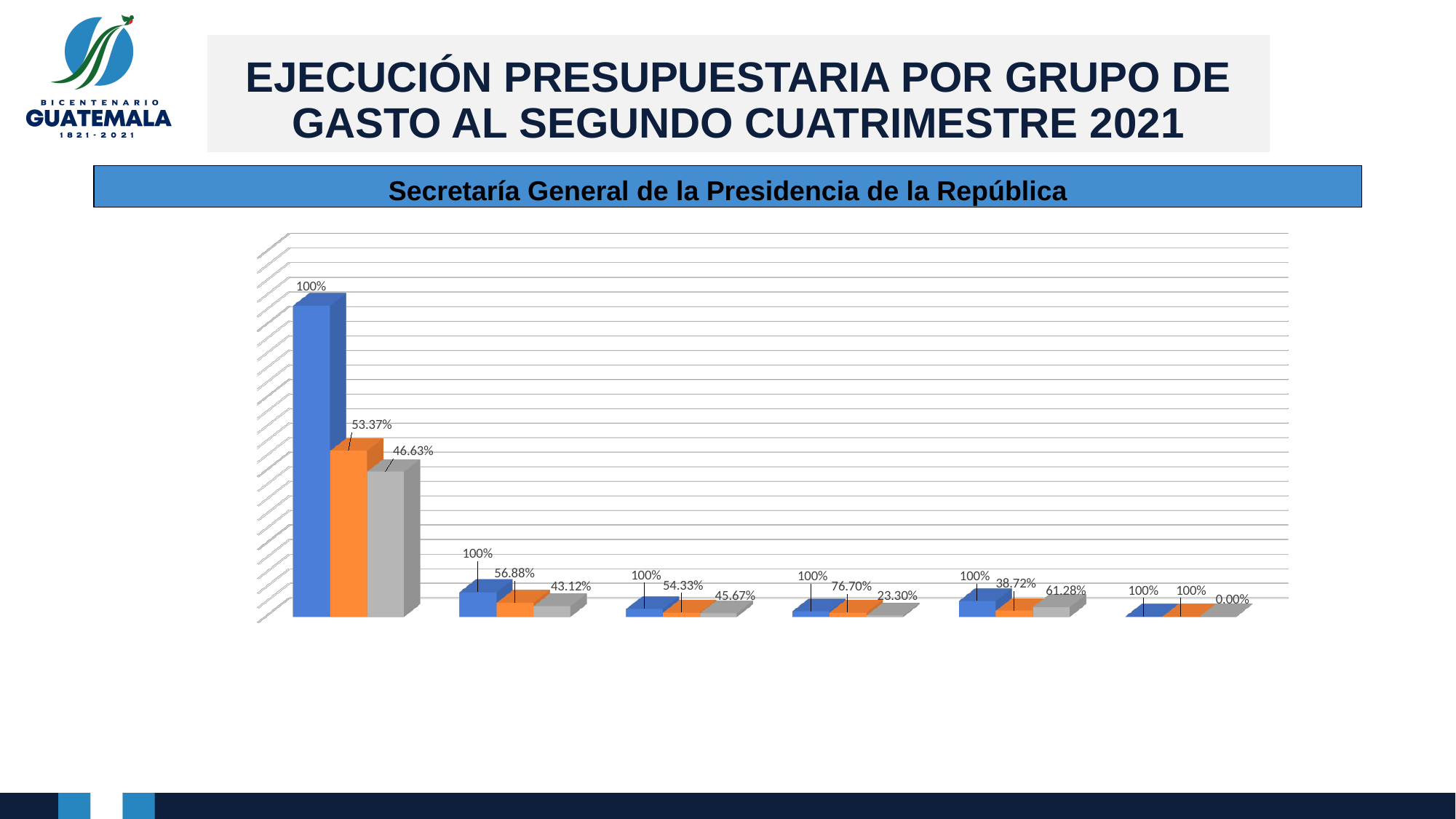
How many groups of bars are plotted in the chart? 6 What is the value of the orange bar in the fourth group of bars? 76.70% What is the value of the gray bar in the sixth (rightmost) group of bars? 0.00% What is the value of the gray bar in the first (leftmost) group of bars? 46.63% In which group of bars is the orange bar the highest? the first (leftmost) group What kind of chart is shown on the slide? bar chart In the first (leftmost) group of bars, what is the difference between the orange bar and the gray bar? 6.74 percentage points What is the value of the gray bar in the fifth group of bars? 61.28% In the fourth group of bars, which is larger, the orange bar or the gray bar? the orange bar What is the value of the orange bar in the second group of bars? 56.88% What is the value of the gray bar in the third group of bars? 45.67% What is the value of the orange bar in the first (leftmost) group of bars? 53.37%